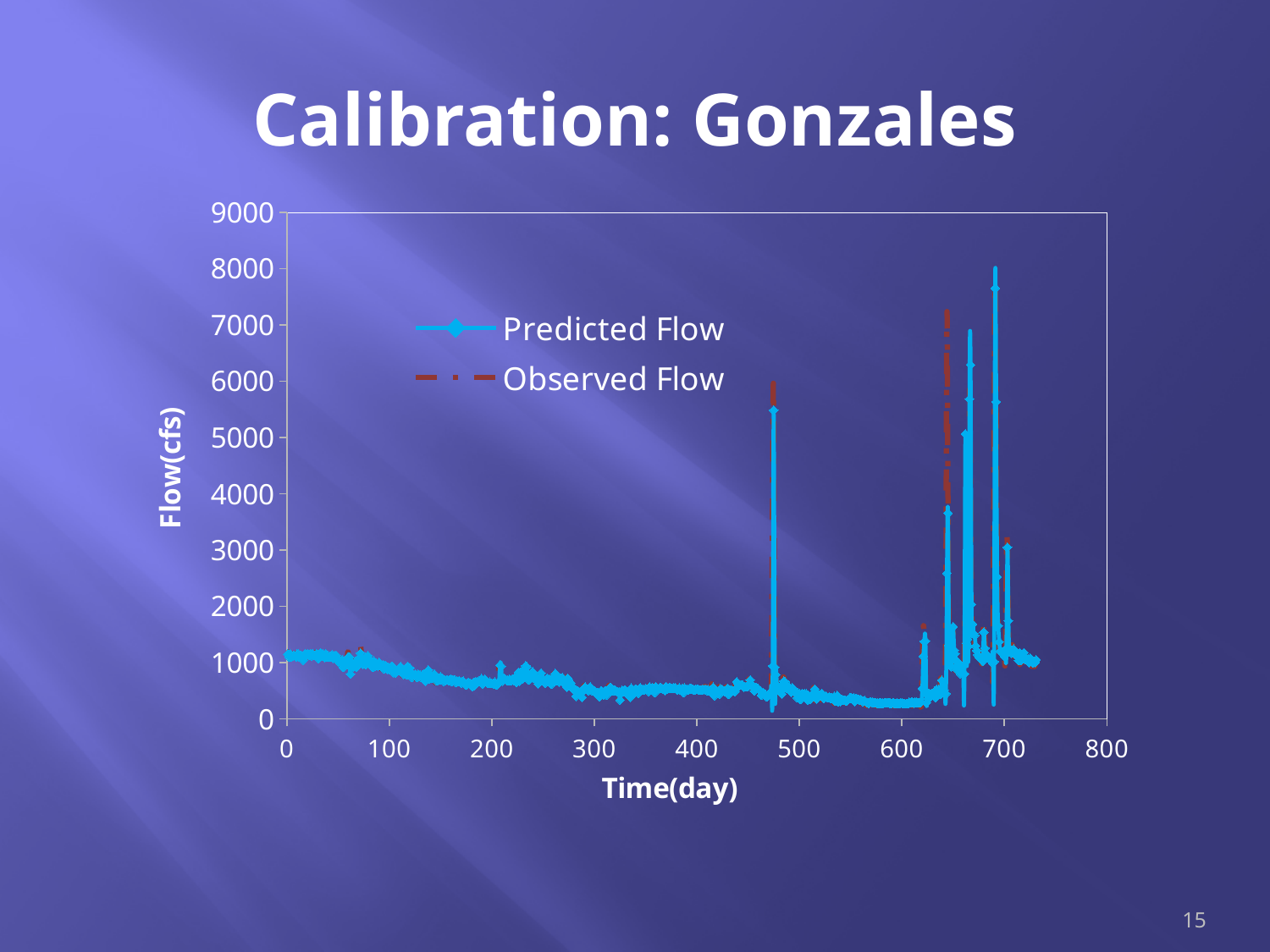
Is the largest spike in Predicted Flow (near day 690) greater or less than 7000? greater What are the two series named in the legend? Predicted Flow and Observed Flow What kind of chart is shown on the slide? line chart What is the highest value shown on the x axis? 800 What is the label of the x axis? Time(day) Is the Predicted Flow spike near day 475 greater or less than 4000? greater Between day 0 and day 300, does the Predicted Flow generally rise or fall? fall What is the label of the y axis? Flow(cfs) How many series does the legend list? 2 What is the highest value shown on the y axis? 9000 What is the title of the slide's chart? Calibration: Gonzales Is the Predicted Flow at day 300 greater or less than 1000? less